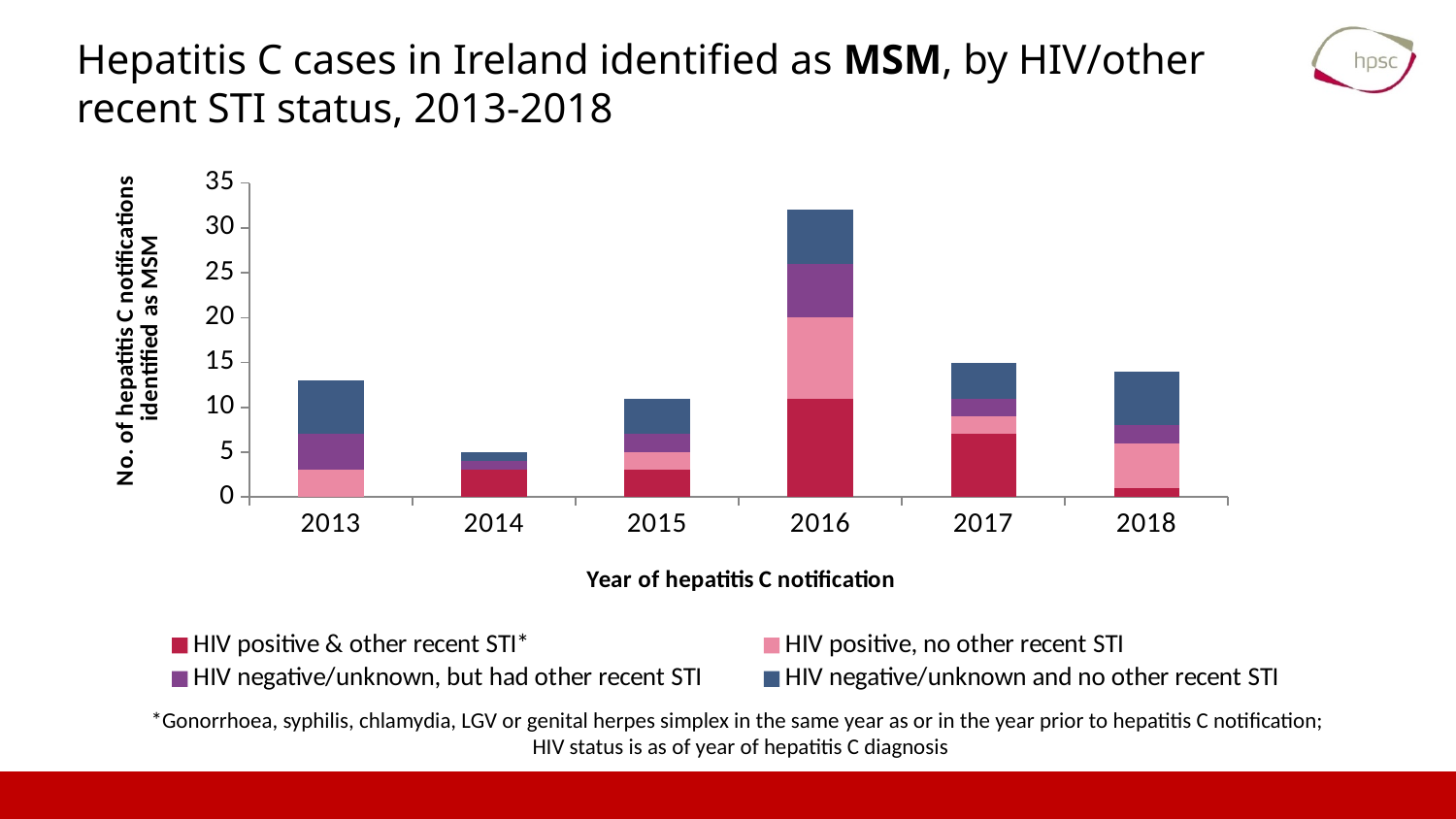
Which legend entry is shown in dark blue? HIV negative/unknown and no other recent STI Is the total number of notifications in 2014 greater or less than 10? less Which year has a larger total number of notifications, 2013 or 2016? 2016 Is the total number of notifications in 2015 greater or less than 15? less Which year has the highest total number of hepatitis C notifications identified as MSM? 2016 What kind of chart is shown on the slide? Stacked bar chart Is the total number of notifications in 2016 greater or less than 30? greater What is the title of the x axis of the chart? Year of hepatitis C notification How many years are shown on the x axis of the chart? 6 How many series does the chart's legend list? 4 Which year has the lowest total number of hepatitis C notifications identified as MSM? 2014